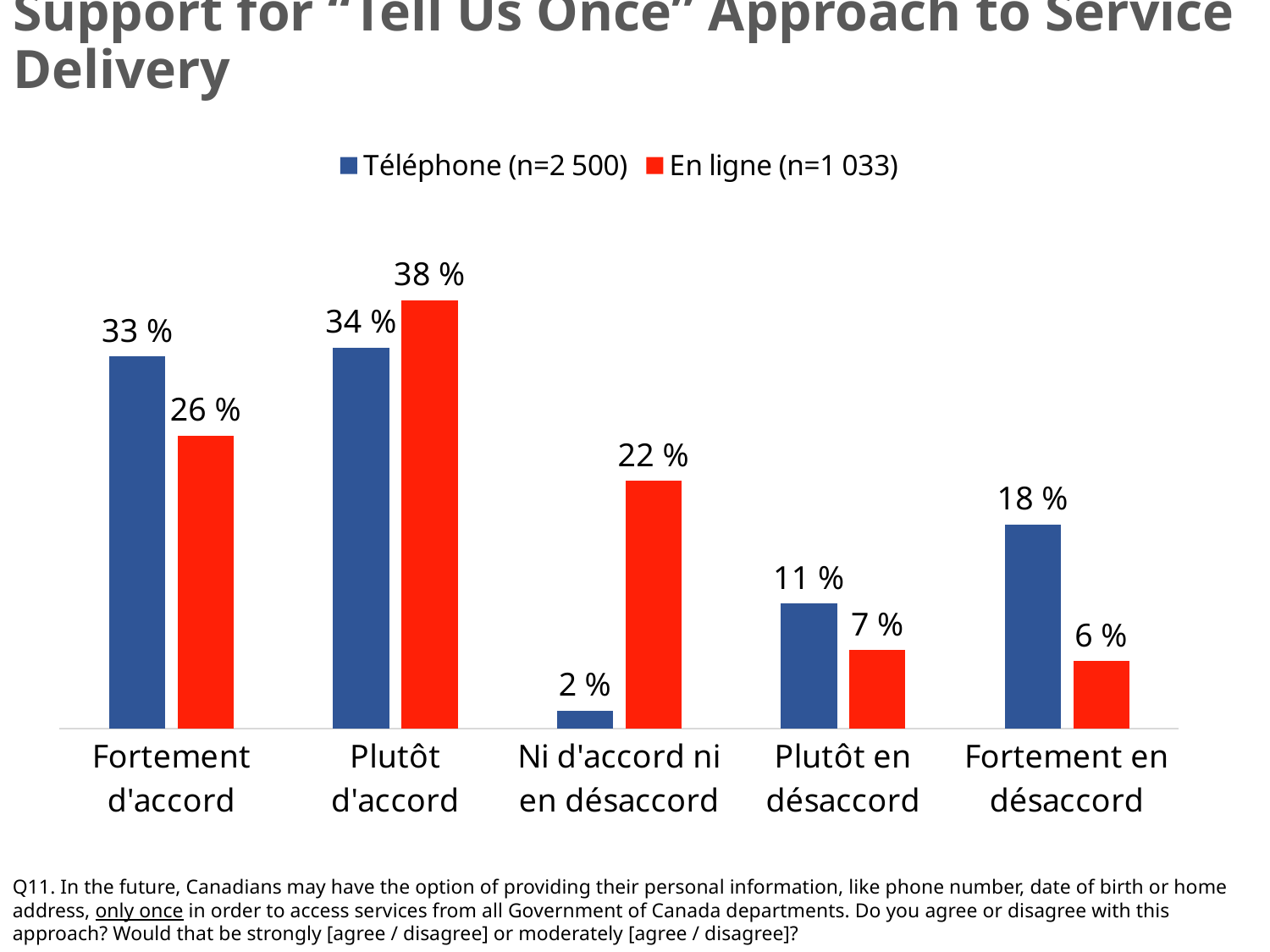
What is the Téléphone value for "Ni d'accord ni en désaccord"? 2 % How many response categories are shown on the x axis? 5 What kind of chart is shown on the slide? Bar chart For "Fortement en désaccord", which series has the larger value, Téléphone or En ligne? Téléphone Which category has the lowest Téléphone value? Ni d'accord ni en désaccord What is the En ligne value for "Plutôt d'accord"? 38 % How many series does the legend list? 2 What is the En ligne value for "Fortement en désaccord"? 6 % What sample size is shown in the legend for the En ligne series? n=1 033 Which category has the highest En ligne value? Plutôt d'accord What is the difference between the En ligne and Téléphone values for "Ni d'accord ni en désaccord"? 20 % What is the Téléphone value for "Fortement d'accord"? 33 %